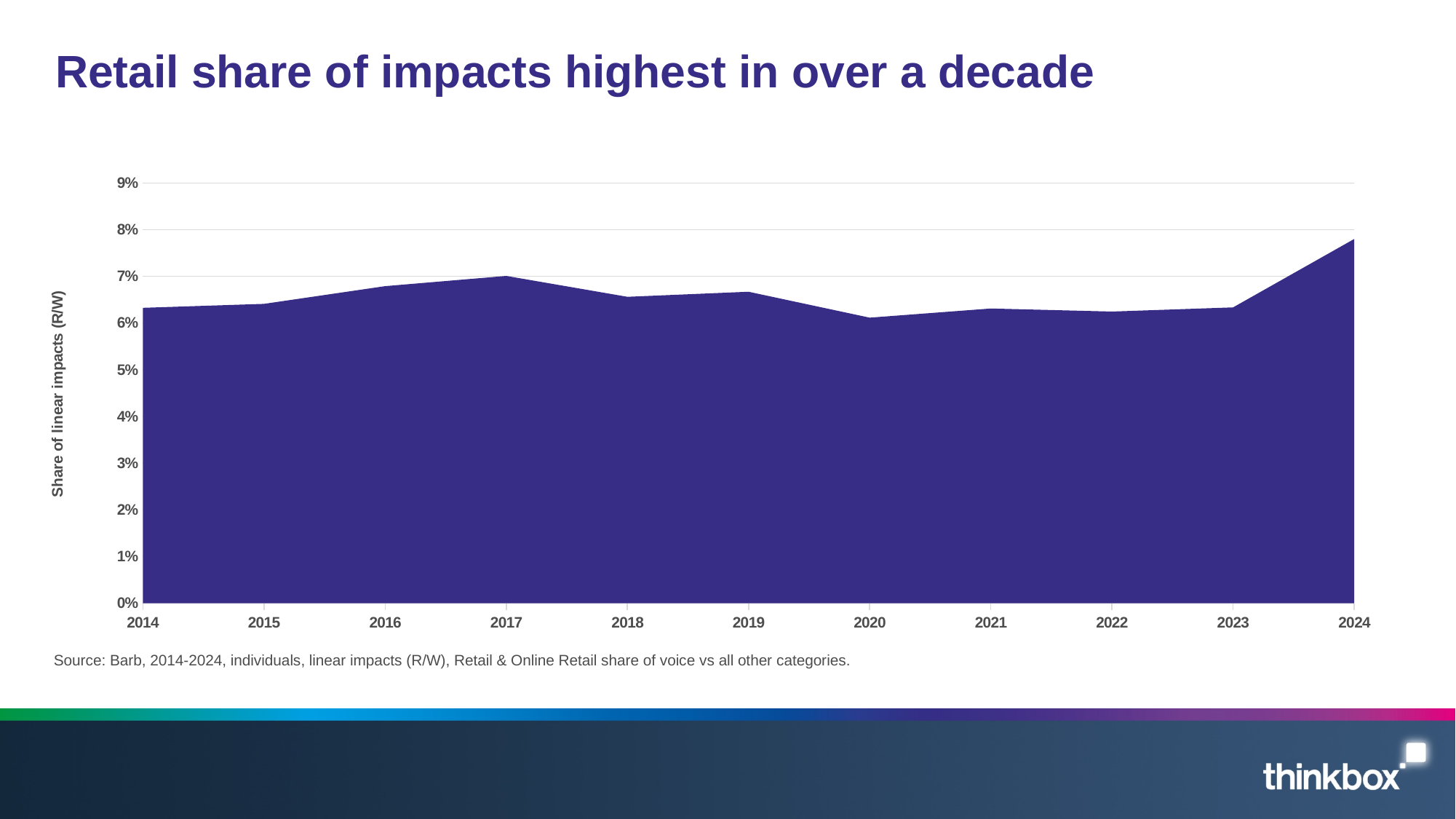
Is the value for 2024 greater or less than 8%? less Is the value for 2024 greater or less than 7%? greater What is the title of the y axis? Share of linear impacts (R/W) Is the value for 2018 greater or less than 7%? less Which year has the larger share of linear impacts, 2014 or 2024? 2024 What kind of chart is shown on the slide? Area chart Does the share of linear impacts rise or fall from 2023 to 2024? rise Which year has the lowest share of linear impacts? 2020 Which year has the highest share of linear impacts? 2024 Which year has the larger share of linear impacts, 2017 or 2020? 2017 How many years are plotted along the x axis? 11